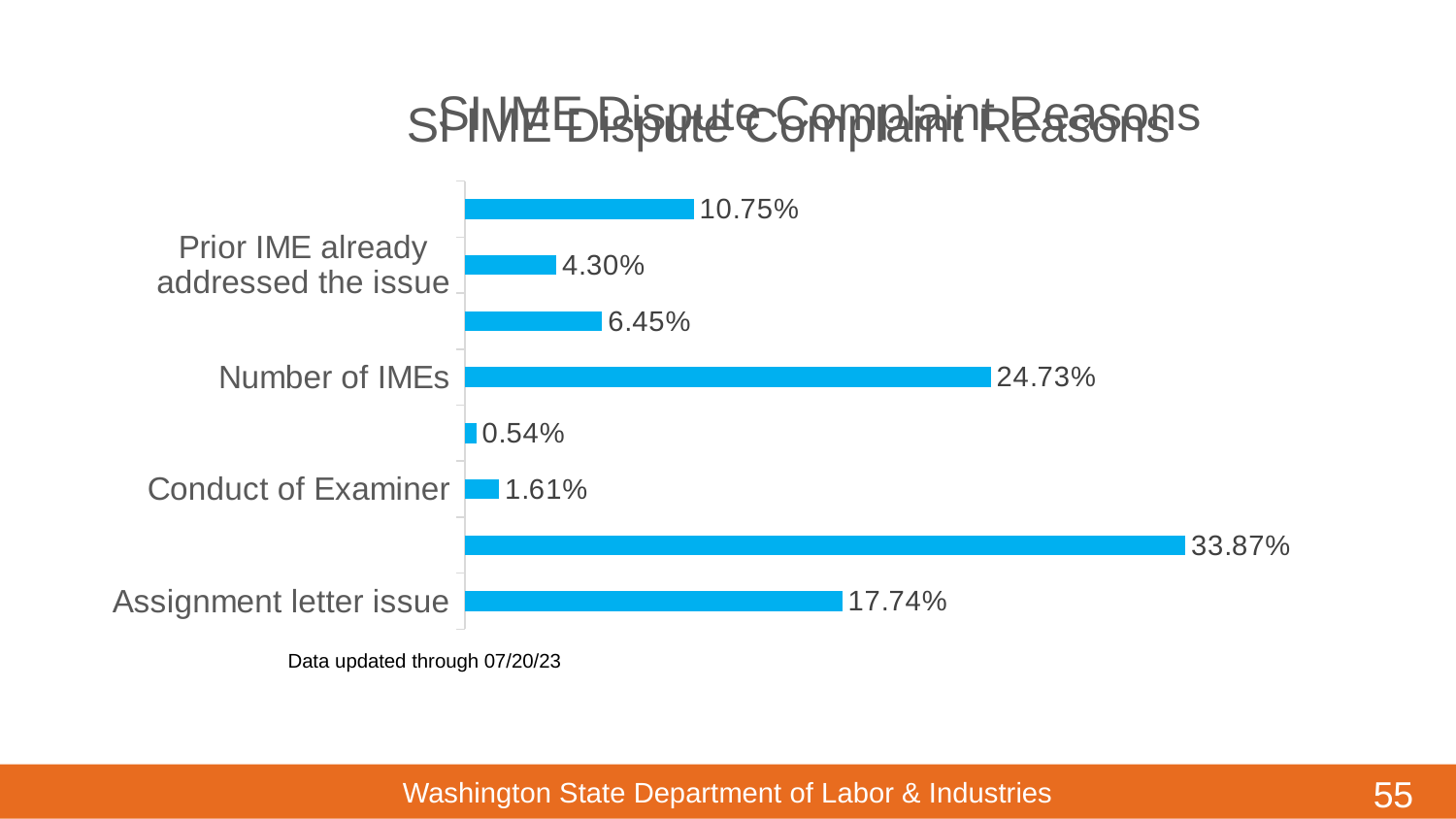
What is the difference between the values for Prior IME already addressed the issue and Conduct of Examiner? 2.69% What is the largest value labeled on any bar in the chart? 33.87% What is the value shown for Prior IME already addressed the issue? 4.30% Which has the larger value, Number of IMEs or Assignment letter issue? Number of IMEs What kind of chart is shown on the slide? bar chart How many bars are plotted in the chart? 8 What is the smallest value labeled on any bar in the chart? 0.54% What is the difference between the values for Number of IMEs and Assignment letter issue? 6.99% What date is the data updated through, according to the note below the chart? 07/20/23 What is the value shown for Conduct of Examiner? 1.61% What is the value shown for Assignment letter issue? 17.74% What is the value shown for Number of IMEs? 24.73%